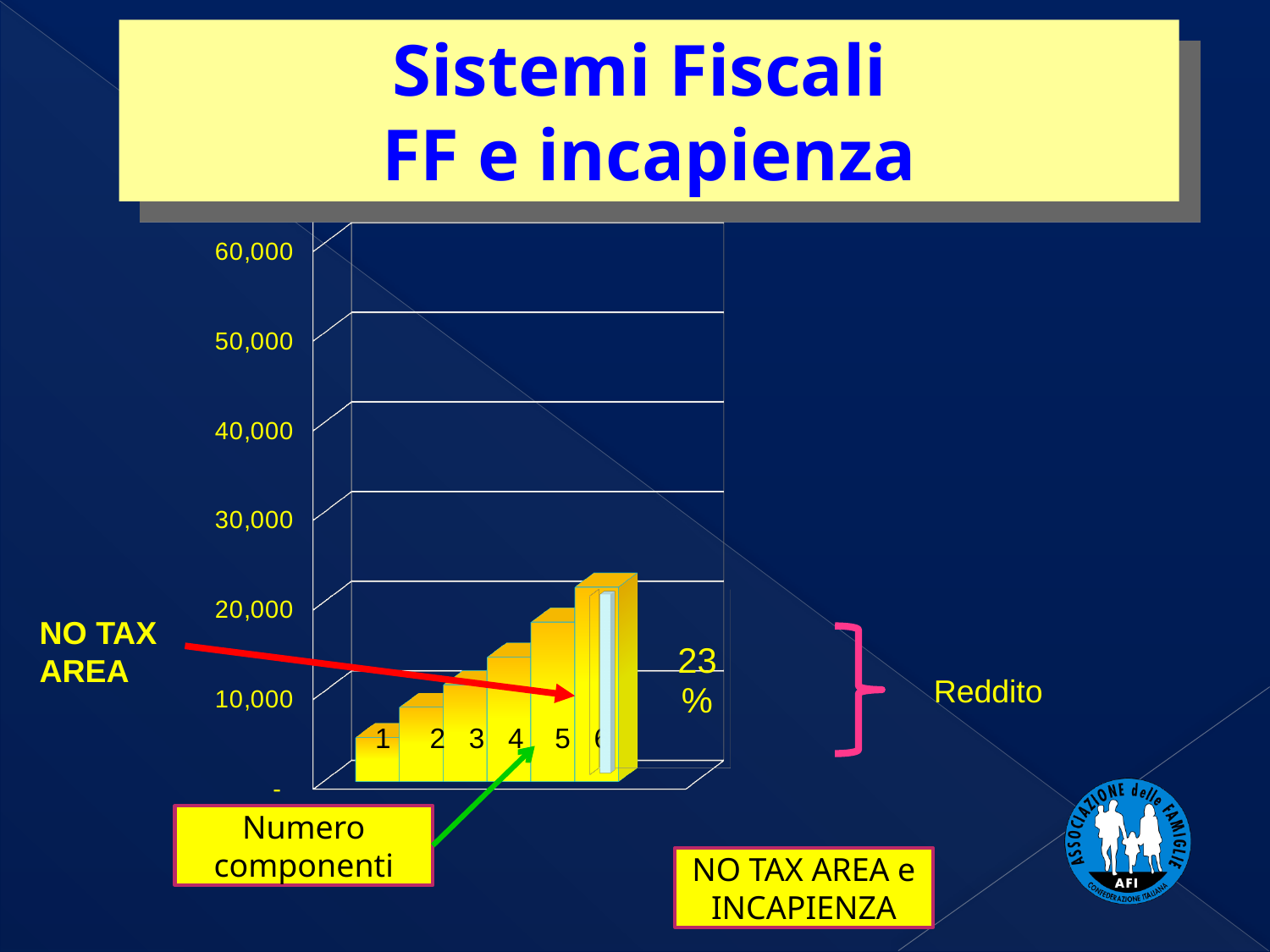
According to the label on the slide, what do the categories 1 to 6 on the horizontal axis represent? Numero componenti What is the highest value shown on the vertical axis of the chart? 60,000 How many bars (categories) are plotted in the chart? 6 Which category has the highest bar in the chart? 6 Is the value for category 4 greater or less than 20,000? less Which is larger, the value for category 2 or the value for category 5? 5 Is the value for category 1 greater or less than 10,000? less Do the bar values rise or fall as the number of components increases from 1 to 6? rise Which category has the lowest bar in the chart? 1 Is the value for category 4 greater or less than 10,000? greater What kind of chart is shown on the slide? bar chart